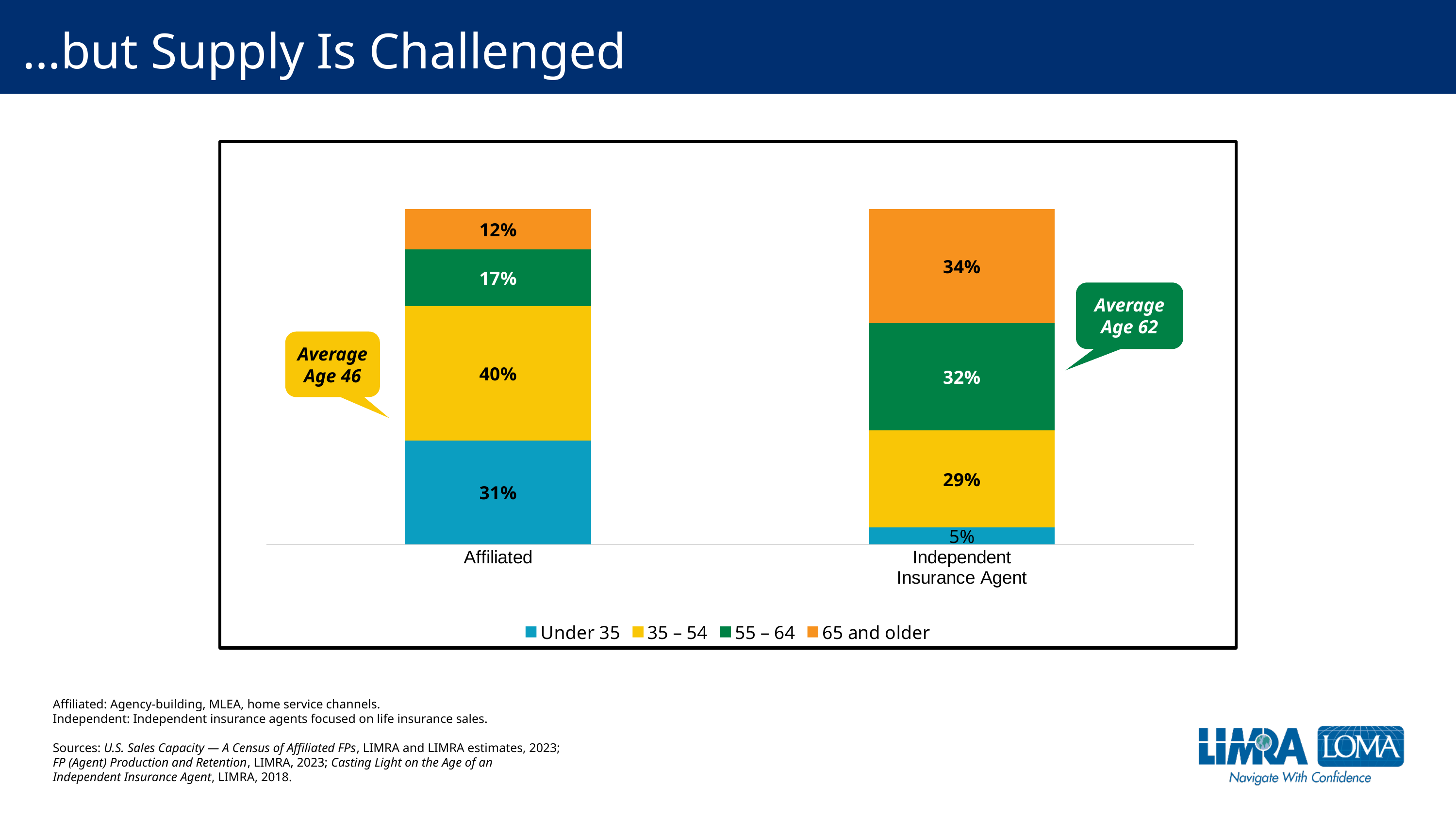
How many series does the legend list? 4 What percentage of Affiliated agents are Under 35? 31% Which age group is the largest share of the Affiliated bar? 35 – 54 Which age group is the smallest share of the Independent Insurance Agent bar? Under 35 What kind of chart is shown on the slide? Stacked bar chart What average age is shown in the callout next to the Independent Insurance Agent bar? Average Age 62 Which category has the larger 55 – 64 share, Affiliated or Independent Insurance Agent? Independent Insurance Agent How many categories are shown on the x axis? 2 What percentage of Independent Insurance Agents are Under 35? 5% What percentage of Independent Insurance Agents are 65 and older? 34% What percentage of Affiliated agents are in the 35 – 54 age group? 40% What is the difference between the Under 35 share for Affiliated and for Independent Insurance Agent? 26%